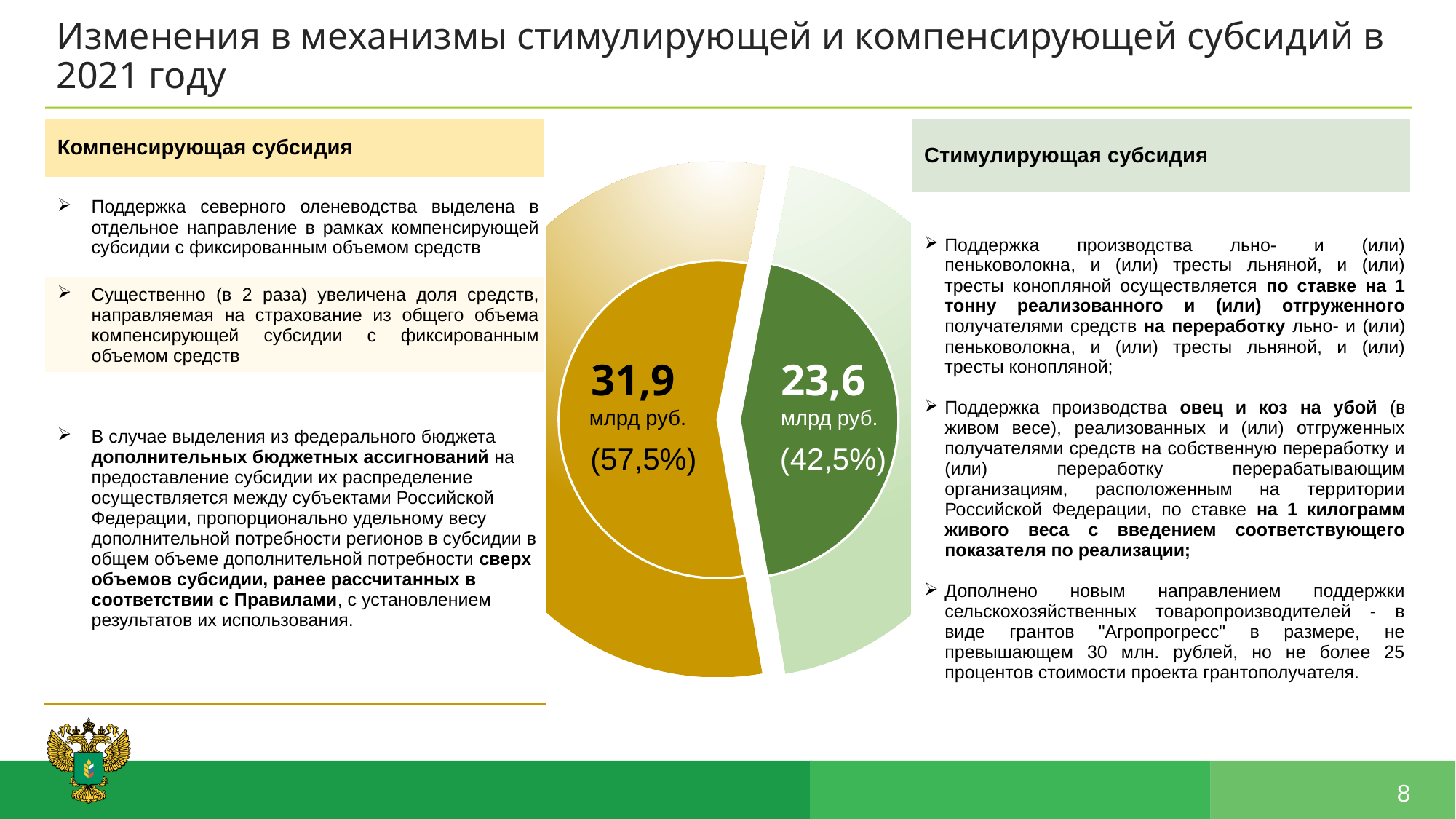
Which slice of the pie chart has the smallest value? the green slice (23,6 млрд руб.) What kind of chart is shown in the centre of the slide? pie chart What is the total of the two values shown on the pie chart, in млрд руб.? 55,5 млрд руб. How many slices does the pie chart have? 2 What value is printed on the yellow slice of the pie chart? 31,9 млрд руб. What share of the pie does the green slice represent? 42,5% Which slice of the pie chart is larger, the yellow one or the green one? the yellow one What is the difference in млрд руб. between the yellow slice and the green slice of the pie chart? 8,3 млрд руб. What value is printed on the green slice of the pie chart? 23,6 млрд руб. Which colour is used for the larger slice of the pie chart? yellow Is the value of the green slice of the pie chart greater or less than 30 млрд руб.? less What share of the pie does the yellow slice represent? 57,5%